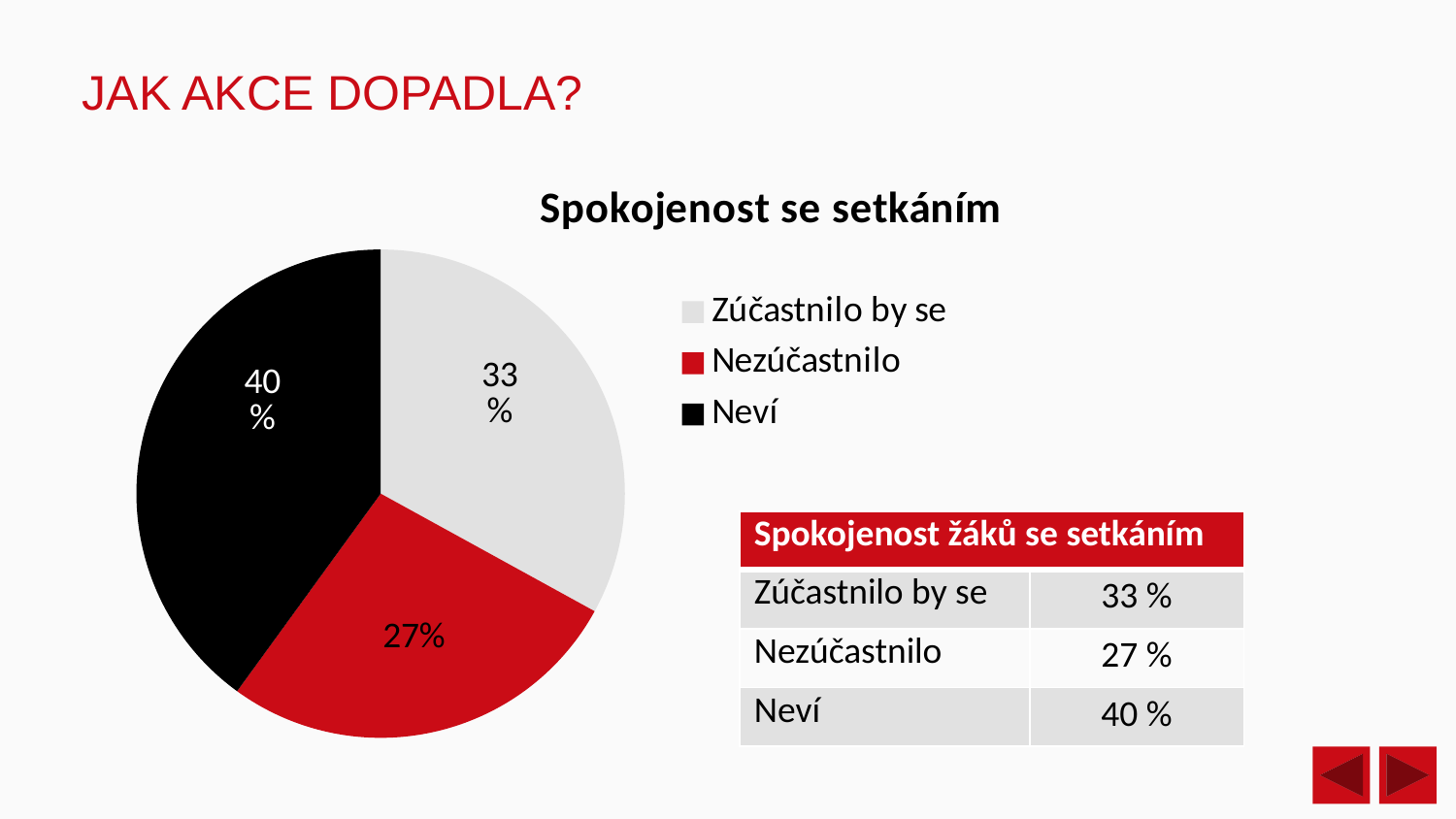
What is the value for Neví? 40 % Which category has the smallest share of the pie? Nezúčastnilo Which colour represents Nezúčastnilo in the legend? red What is the difference between the Neví and Nezúčastnilo shares? 13 % How many slices does the pie chart have? 3 What is the value for Nezúčastnilo? 27% Which category has the largest share of the pie? Neví What kind of chart is shown on the slide? pie chart What is the value for Zúčastnilo by se? 33 % What share of the pie does Neví represent? 40 % Which is larger, Zúčastnilo by se or Nezúčastnilo? Zúčastnilo by se What is the chart's title? Spokojenost se setkáním